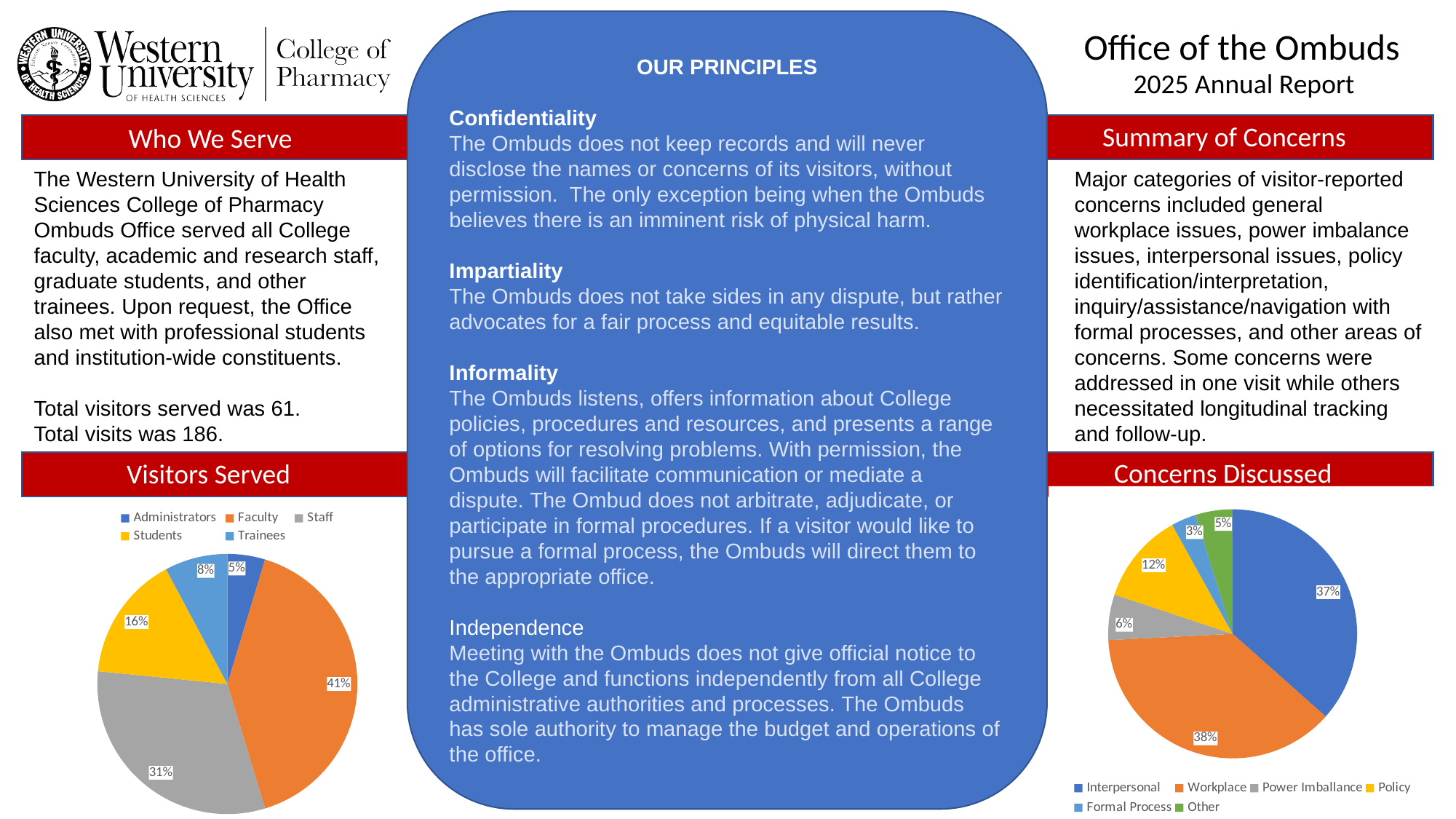
What type of chart is the Visitors Served chart? Pie chart In the Concerns Discussed chart, which category has the smallest share? Formal Process In the Visitors Served chart, which category has the smallest share? Administrators How many categories does the legend of the Concerns Discussed chart list? 6 In the Visitors Served chart, what percentage is shown for Staff? 31% In the Visitors Served chart, what is the difference between the Students and Trainees shares? 8% In the Concerns Discussed chart, which is larger, Interpersonal or Workplace? Workplace In the Visitors Served chart, which category has the largest share? Faculty In the Concerns Discussed chart, what is the difference between the Power Imbalance and Other shares? 1% In the Visitors Served chart, what share of visitors were Faculty? 41% In the Concerns Discussed chart, what share is shown for Policy? 12% How many categories does the Visitors Served pie chart show? 5